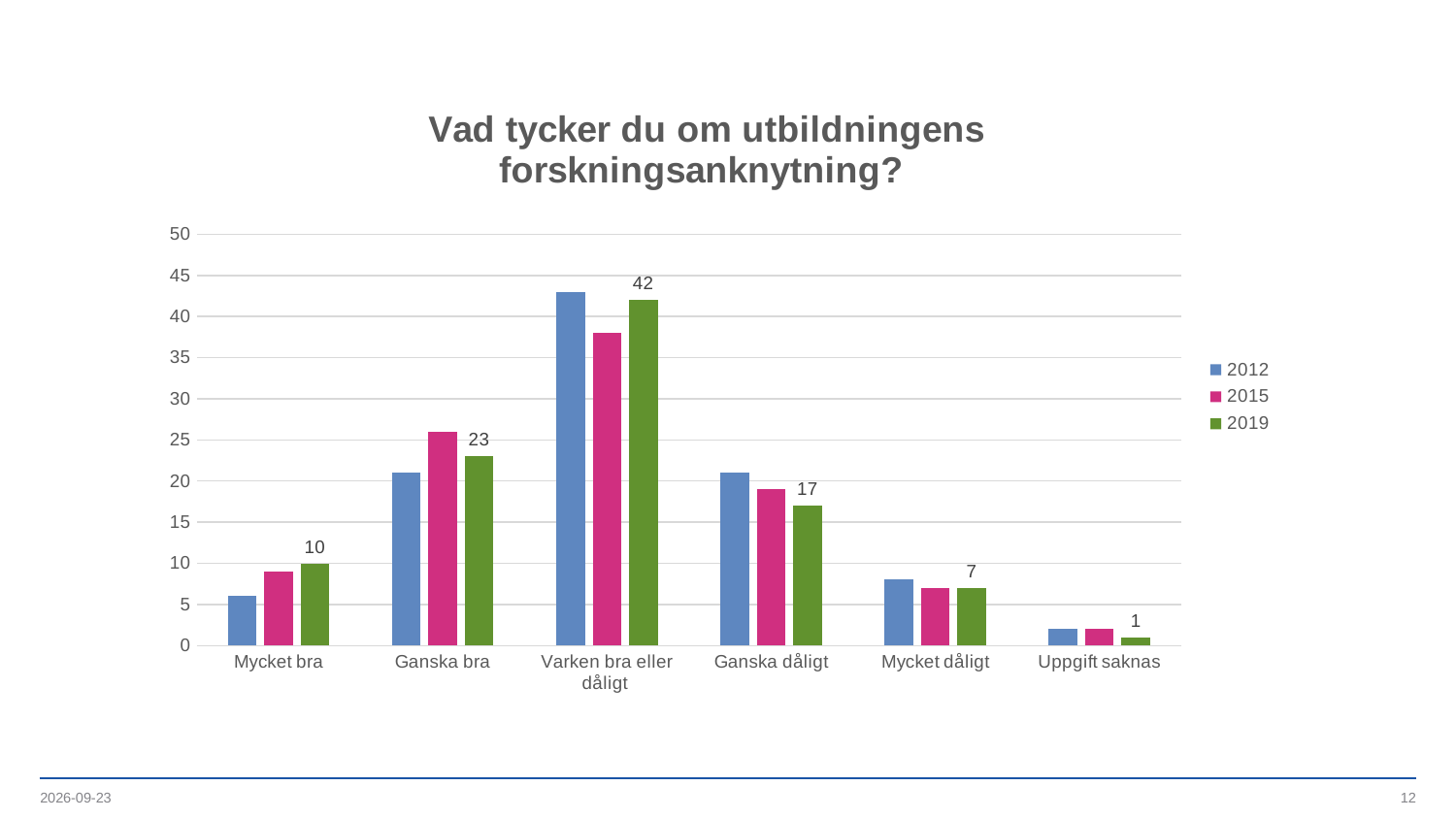
Is the value for 2012 in the "Varken bra eller dåligt" category greater or less than 40? greater What is the difference between the 2019 values for "Mycket bra" and "Mycket dåligt"? 3 Which category has the lowest value for the 2019 series? Uppgift saknas What is the value for 2019 in the "Uppgift saknas" category? 1 What is the value for 2019 in the "Varken bra eller dåligt" category? 42 How many series does the legend list? 3 What is the difference between the 2019 values for "Varken bra eller dåligt" and "Ganska bra"? 19 For the 2019 series, which is larger: "Ganska bra" or "Ganska dåligt"? Ganska bra What is the value for 2019 in the "Ganska bra" category? 23 How many categories are shown on the x axis? 6 What kind of chart is shown on the slide? Bar chart Which category has the highest value for the 2019 series? Varken bra eller dåligt